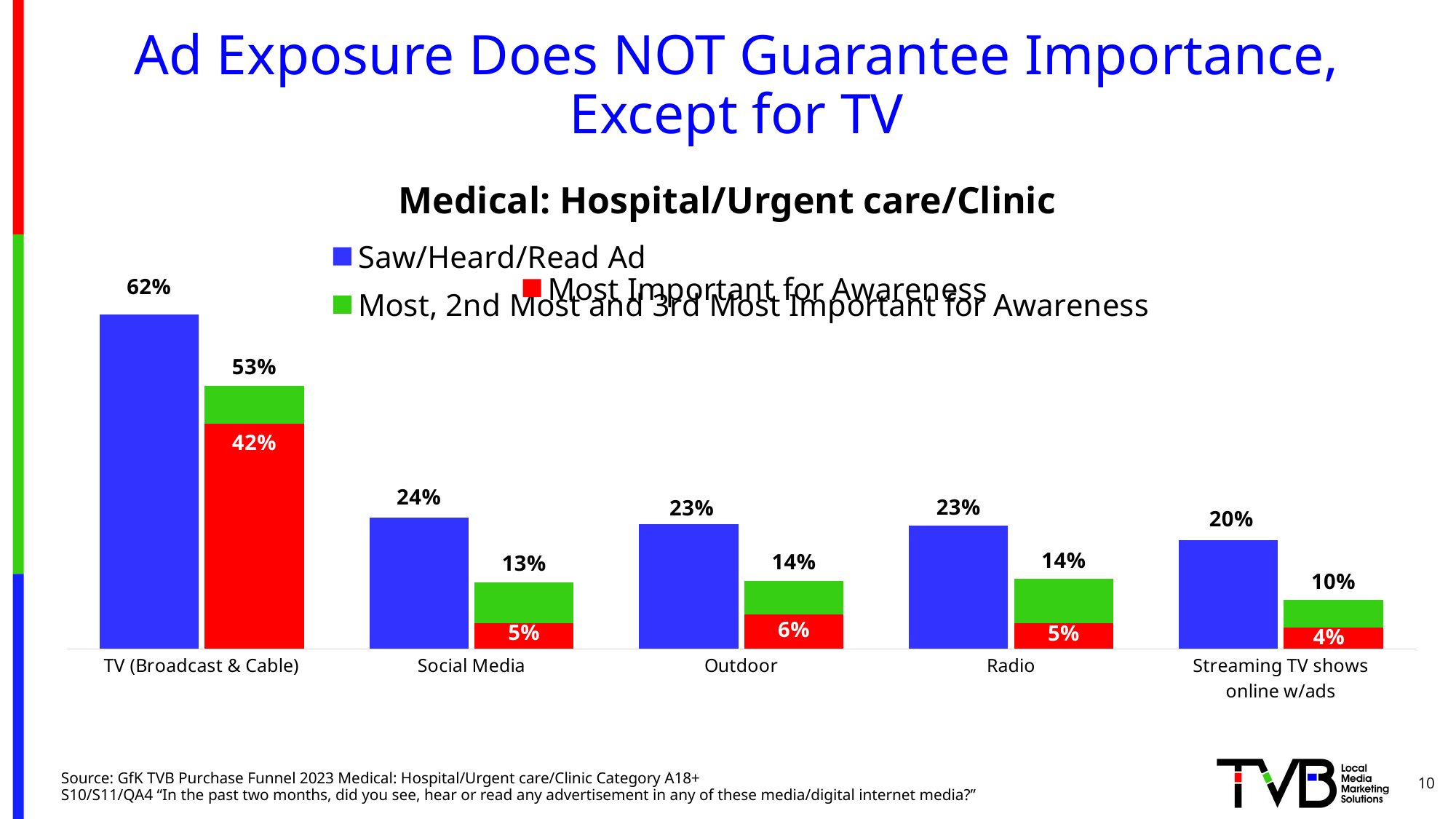
What is the Most Important for Awareness value for Outdoor? 6% How many series does the legend list? 3 What is the title of the chart? Medical: Hospital/Urgent care/Clinic What is the difference between the Saw/Heard/Read Ad values for TV (Broadcast & Cable) and Social Media? 38 percentage points What is the total at the top of the stacked bar for Radio? 14% What is the Saw/Heard/Read Ad value for TV (Broadcast & Cable)? 62% Which category has the highest Saw/Heard/Read Ad value? TV (Broadcast & Cable) How many media categories are shown on the x axis? 5 Which has a larger Saw/Heard/Read Ad value, Social Media or Streaming TV shows online w/ads? Social Media Which category has the lowest Most Important for Awareness value? Streaming TV shows online w/ads What is the Most Important for Awareness value for TV (Broadcast & Cable)? 42% What kind of chart is shown on the slide? Bar chart